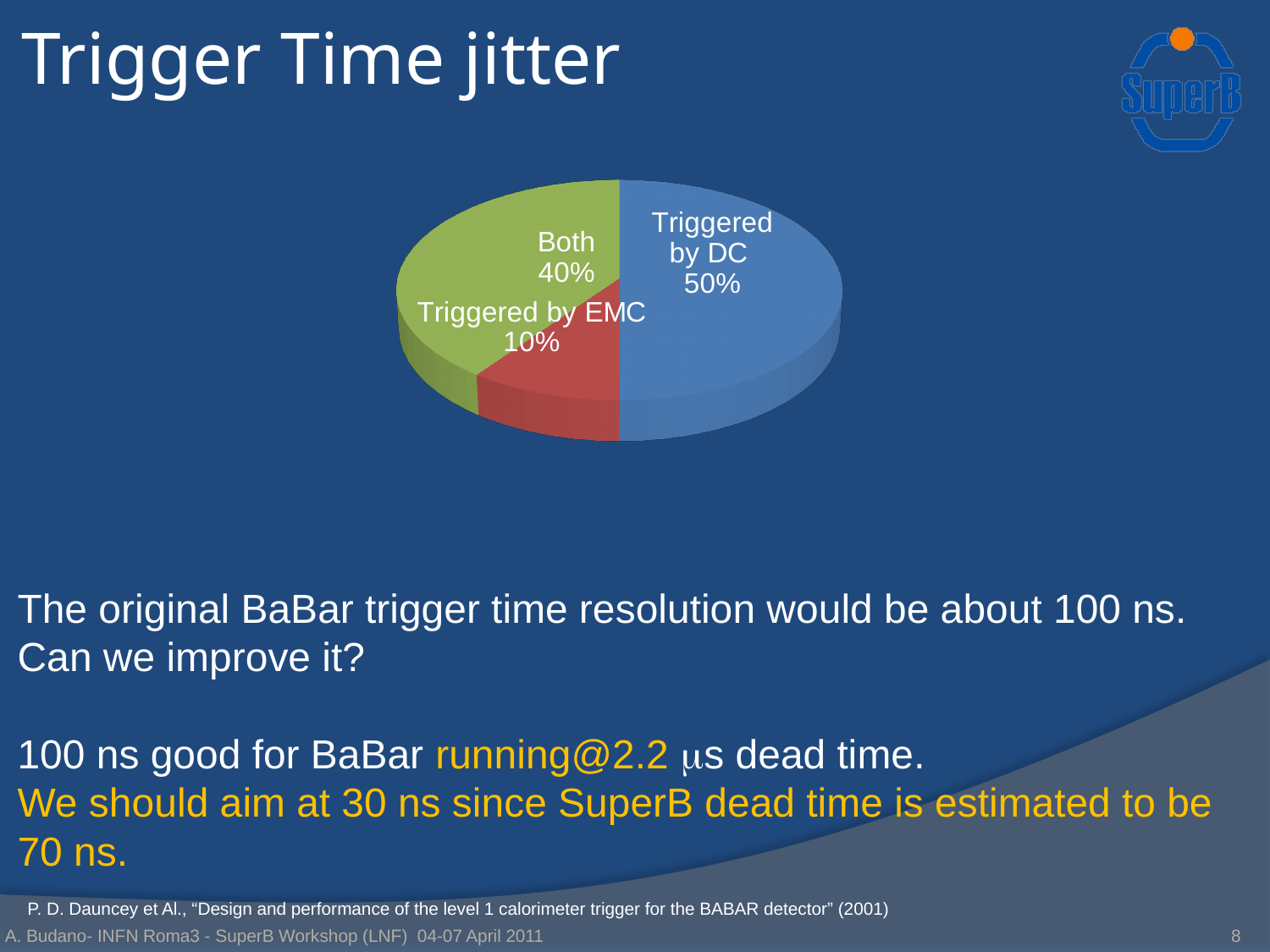
How many slices does the pie chart have? 3 What share of the pie is labelled "Triggered by DC"? 50% What colour is the "Triggered by DC" slice? blue What is the difference in percentage points between the "Both" slice and the "Triggered by EMC" slice? 30% What kind of chart is shown on the slide? pie chart What is the difference in percentage points between the "Triggered by DC" slice and the "Both" slice? 10% Which is larger, the "Both" slice or the "Triggered by EMC" slice? Both What share of the pie is labelled "Both"? 40% Which slice of the pie chart is the largest? Triggered by DC What share of the pie is labelled "Triggered by EMC"? 10% Which slice of the pie chart is the smallest? Triggered by EMC What colour is the "Both" slice? green